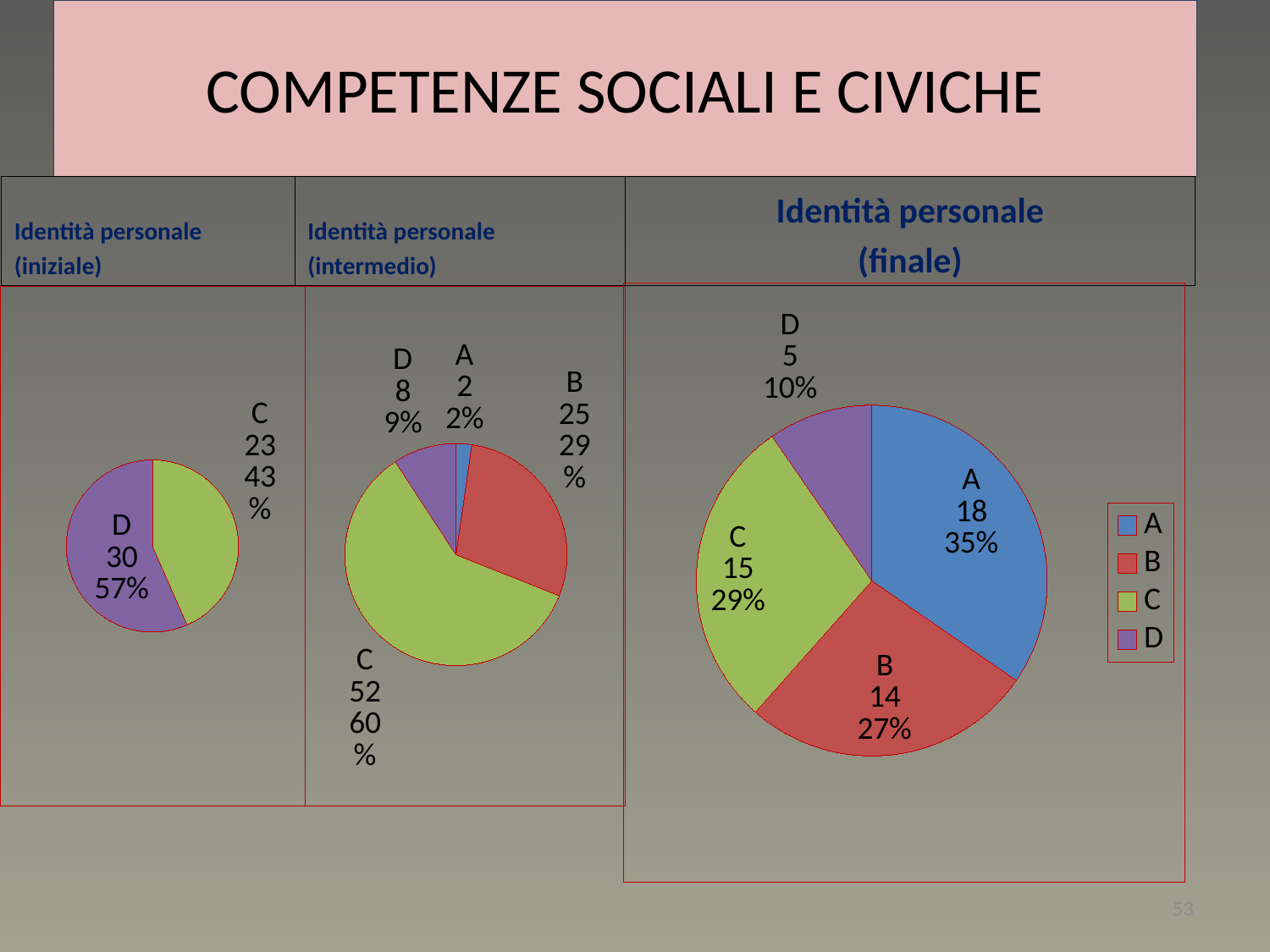
In the 'Identità personale (finale)' pie chart, which category has the largest slice? A How many slices does the 'Identità personale (iniziale)' pie chart have? 2 In the 'Identità personale (intermedio)' pie chart, which category has the smallest slice? A In the 'Identità personale (iniziale)' pie chart, what percentage share does category C have? 43% In the 'Identità personale (finale)' pie chart, how many categories does the legend list? 4 In the 'Identità personale (finale)' pie chart, what is the difference between the values for A and B? 4 What type of chart is used for 'Identità personale (finale)'? Pie chart In the 'Identità personale (iniziale)' pie chart, what value is shown for category D? 30 In the 'Identità personale (intermedio)' pie chart, what value is shown for category B? 25 In the 'Identità personale (intermedio)' pie chart, which category has the largest slice? C In the 'Identità personale (intermedio)' pie chart, what percentage share does category D have? 9% In the 'Identità personale (finale)' pie chart, what value is shown for category A? 18